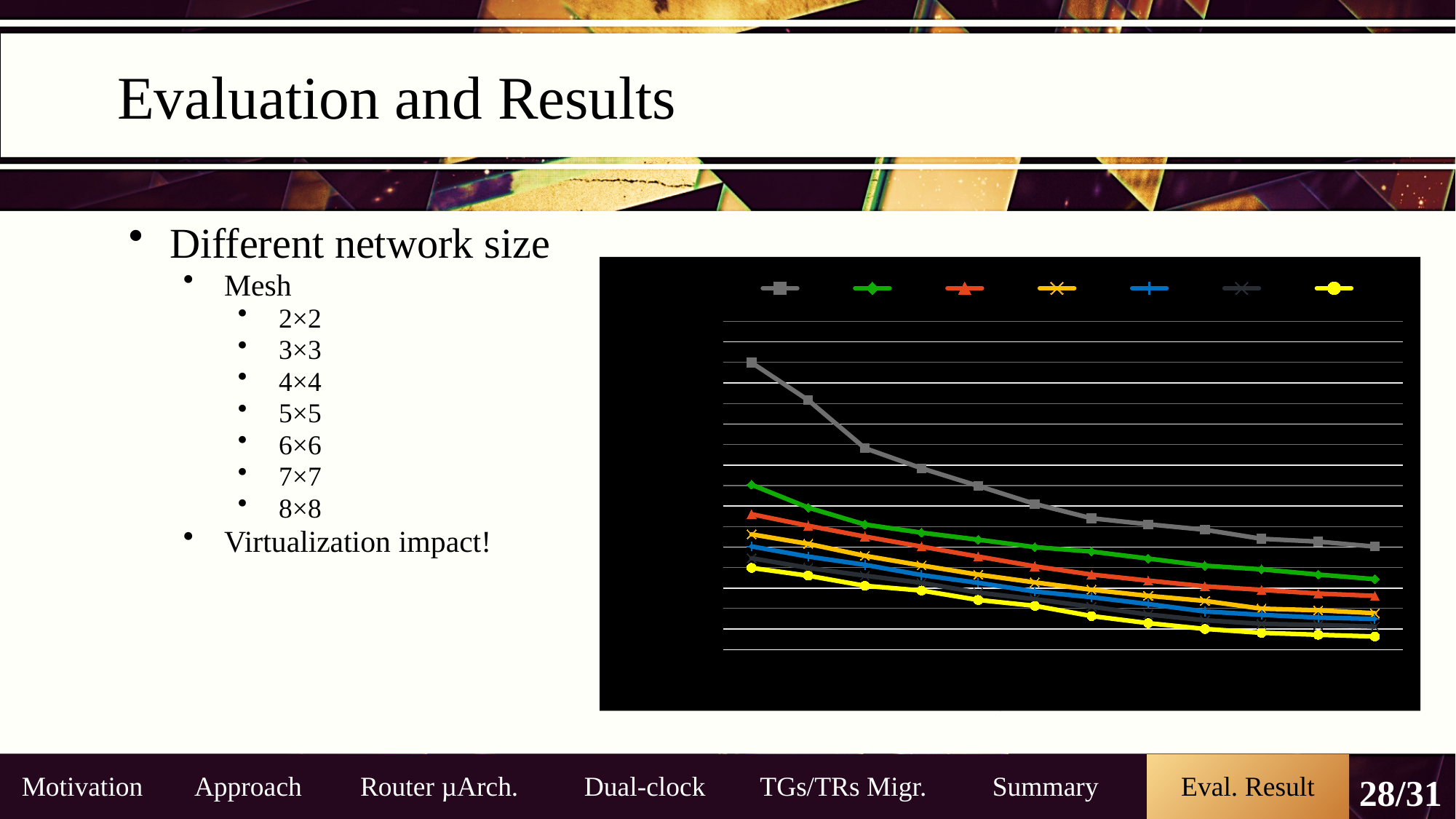
How many series does the chart's legend list? 7 What kind of chart is shown on the slide? line chart Do the values of the lines in the chart rise or fall from left to right along the x axis? fall How many data points does each line in the chart have? 12 Which colour is the line that sits lowest on the chart? yellow Which colour is the line that sits highest on the chart? grey